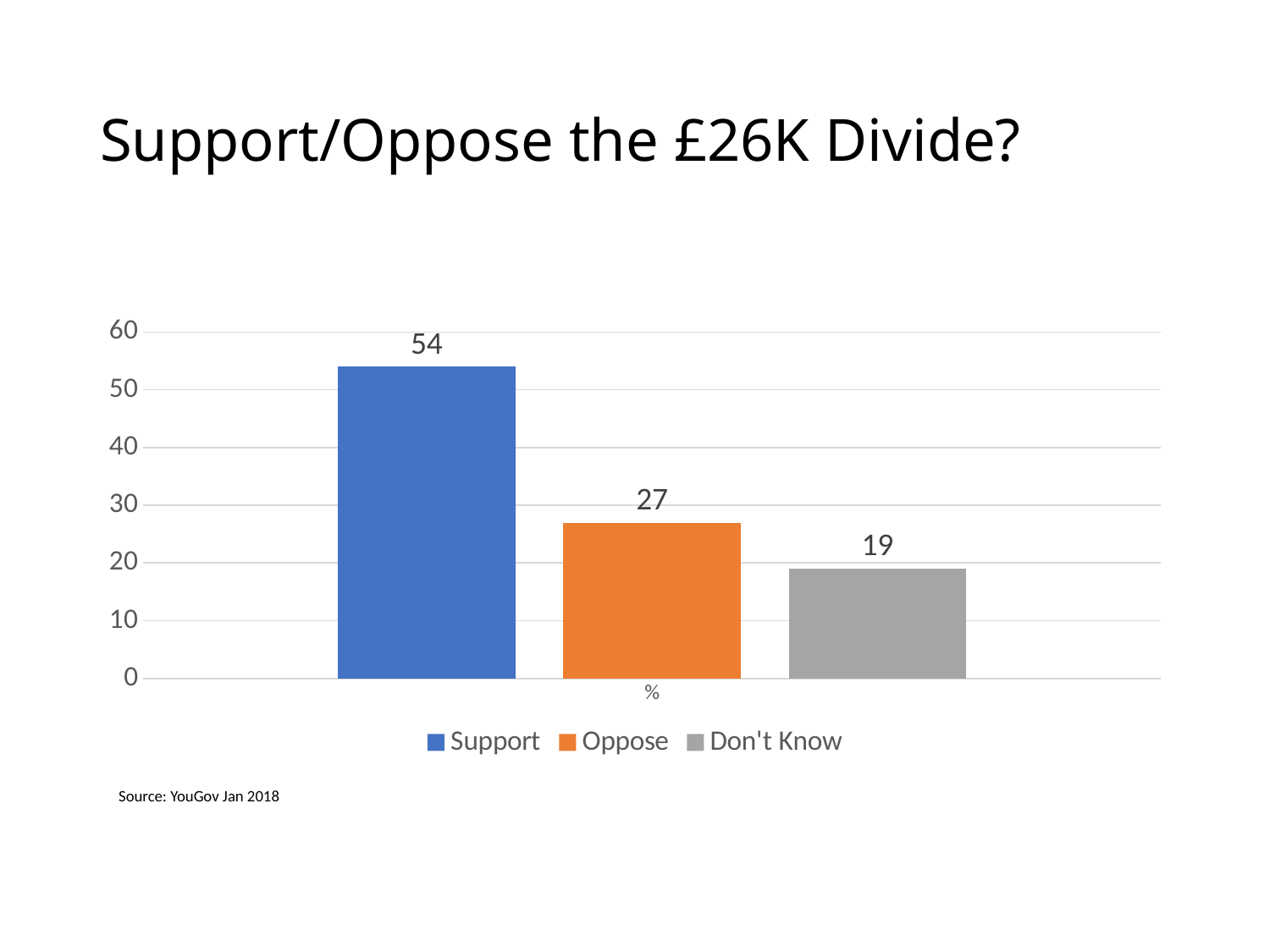
What is the title of the slide? Support/Oppose the £26K Divide? What is the value for Don't Know? 19 What is the difference between the Support and Oppose values? 27 Which series has the highest value? Support What is the value for Support? 54 Which is larger, Oppose or Don't Know? Oppose How many series does the legend list? 3 Which series has the lowest value? Don't Know What is the value for Oppose? 27 What kind of chart is shown on the slide? bar chart What is the difference between the Oppose and Don't Know values? 8 Is the value for Support greater or less than 50? greater